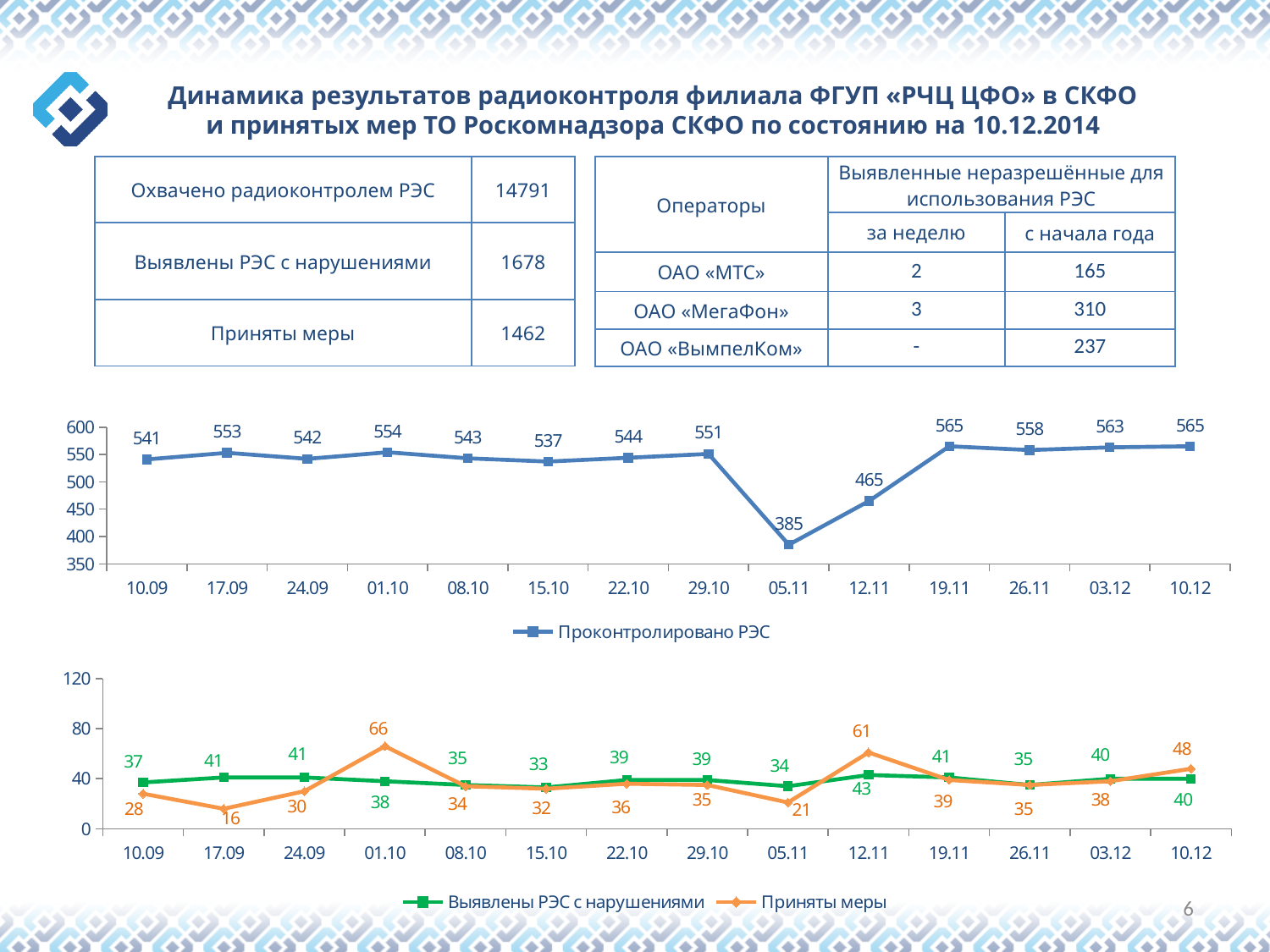
In the top chart, what is the value of Проконтролировано РЭС on 05.11? 385 In the bottom chart, on which date is the value of Выявлены РЭС с нарушениями highest? 12.11 In the bottom chart, on which date is the value of Приняты меры lowest? 17.09 In the bottom chart, which is larger on 05.11: Выявлены РЭС с нарушениями or Приняты меры? Выявлены РЭС с нарушениями In the top chart, what is the difference between the values on 19.11 and 12.11? 100 How many series does the legend of the bottom chart list? 2 What type of chart is the top chart? Line chart In the top chart, what series name is shown in the legend? Проконтролировано РЭС In the bottom chart, what is the value of Приняты меры on 01.10? 66 In the top chart, how many data points are plotted? 14 In the bottom chart, what is the difference between Приняты меры and Выявлены РЭС с нарушениями on 12.11? 18 In the top chart, on which date is the value of Проконтролировано РЭС lowest? 05.11